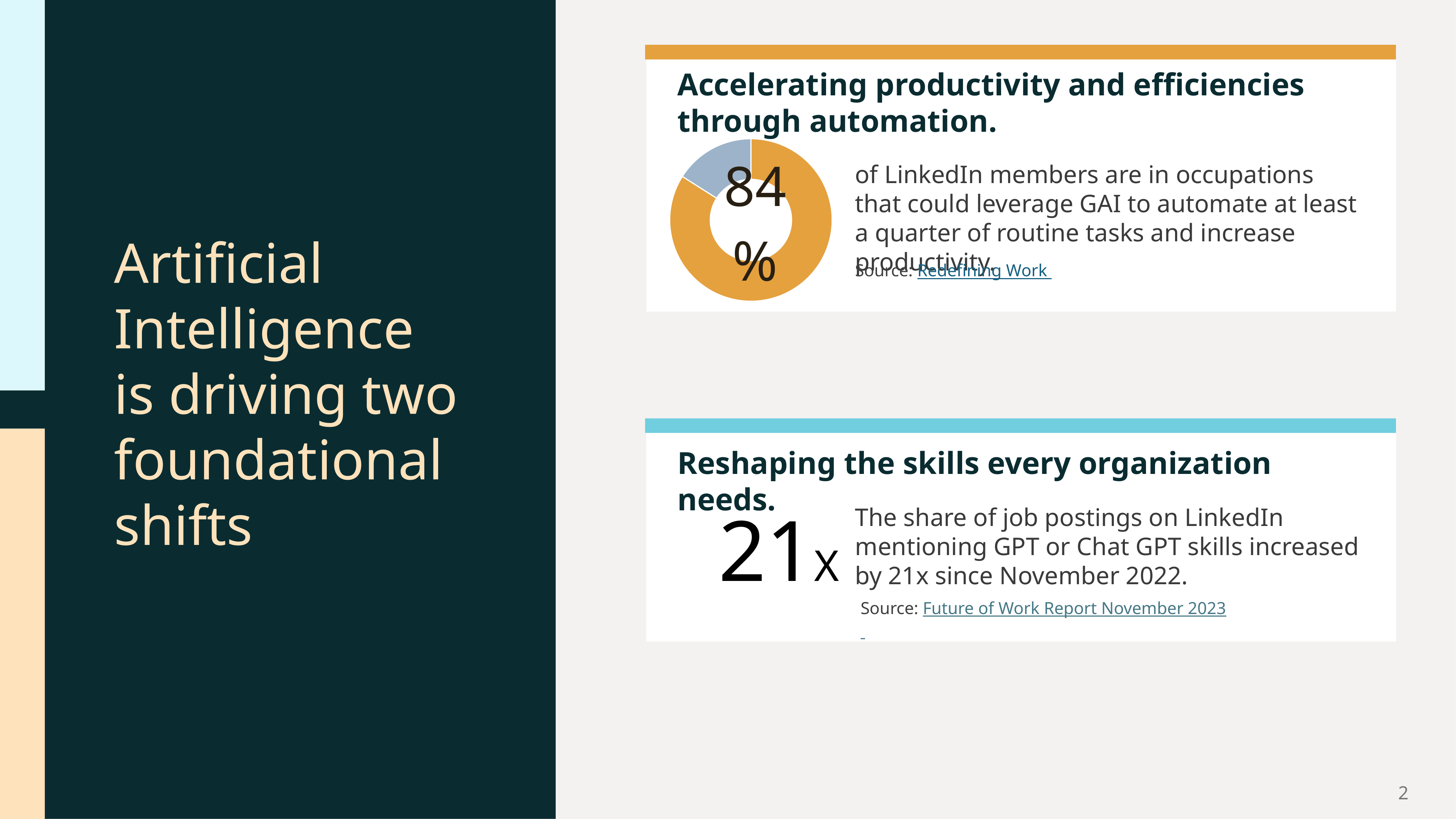
How many slices does the donut chart have? 2 What is the title of the panel containing the donut chart? Accelerating productivity and efficiencies through automation. What share of the donut chart does the orange slice represent? 84% What percentage of LinkedIn members are in occupations that could leverage GAI to automate at least a quarter of routine tasks, according to the donut chart? 84% What kind of chart is shown in the top panel of the slide? Pie chart (donut) What share of the donut chart does the smaller blue-grey slice represent? 16% What value is printed in the centre of the donut chart? 84% What colour is the largest slice of the donut chart? Orange Which slice of the donut chart is larger, the orange one or the blue-grey one? The orange one